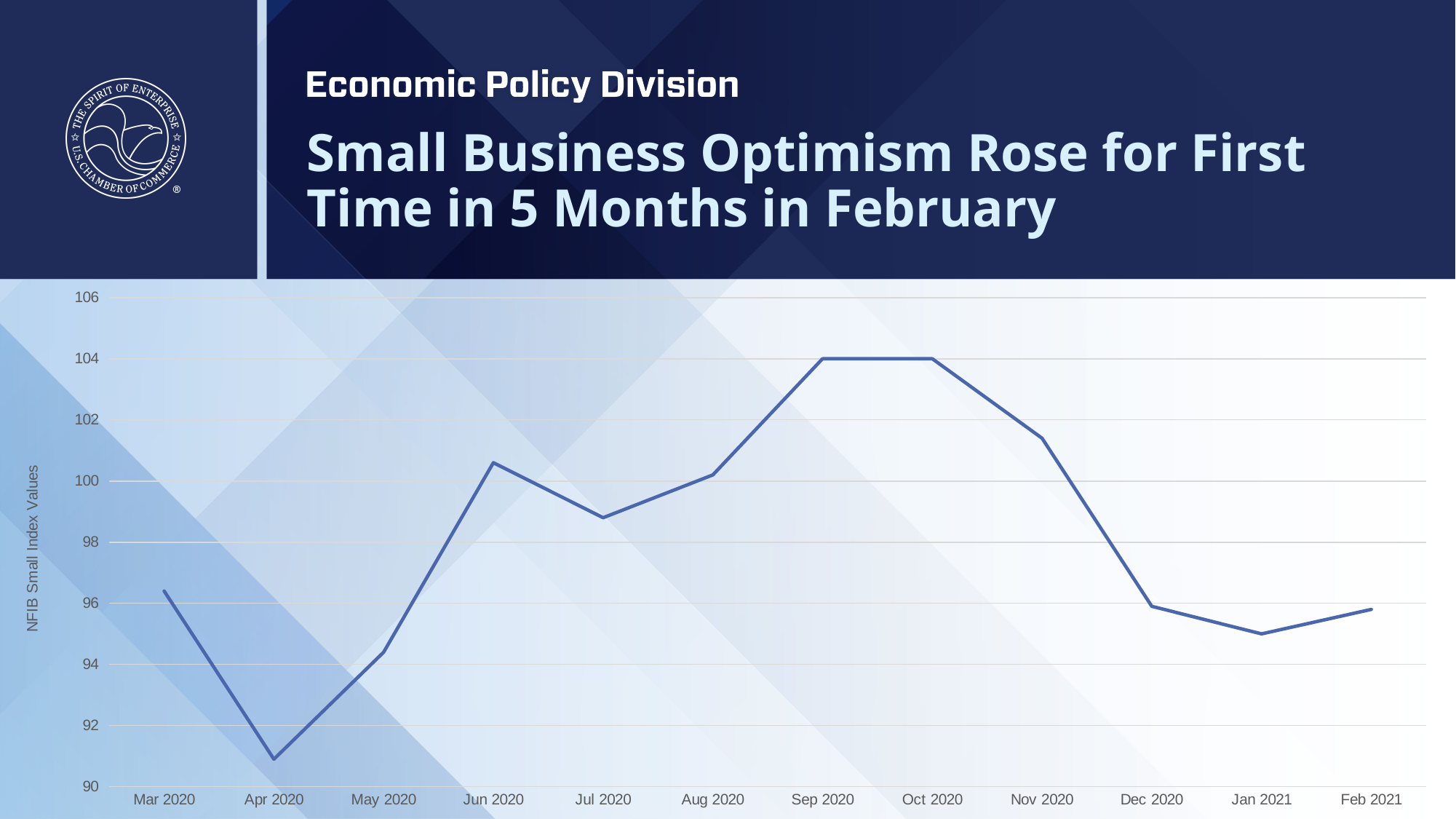
How many monthly data points are plotted on the chart? 12 Is the value for Jul 2020 greater or less than 100? less Is the value for Jun 2020 greater or less than 100? greater What is the label on the vertical axis of the chart? NFIB Small Index Values What kind of chart is shown on the slide? line chart What is the NFIB Small Index value for Sep 2020? 104 Is the value for Jan 2021 greater or less than 96? less Which is larger, the value for Nov 2020 or the value for Dec 2020? Nov 2020 Do the values rise or fall from Oct 2020 to Jan 2021? fall Which is larger, the value for Jun 2020 or the value for Jul 2020? Jun 2020 Which month has the lowest NFIB Small Index value? Apr 2020